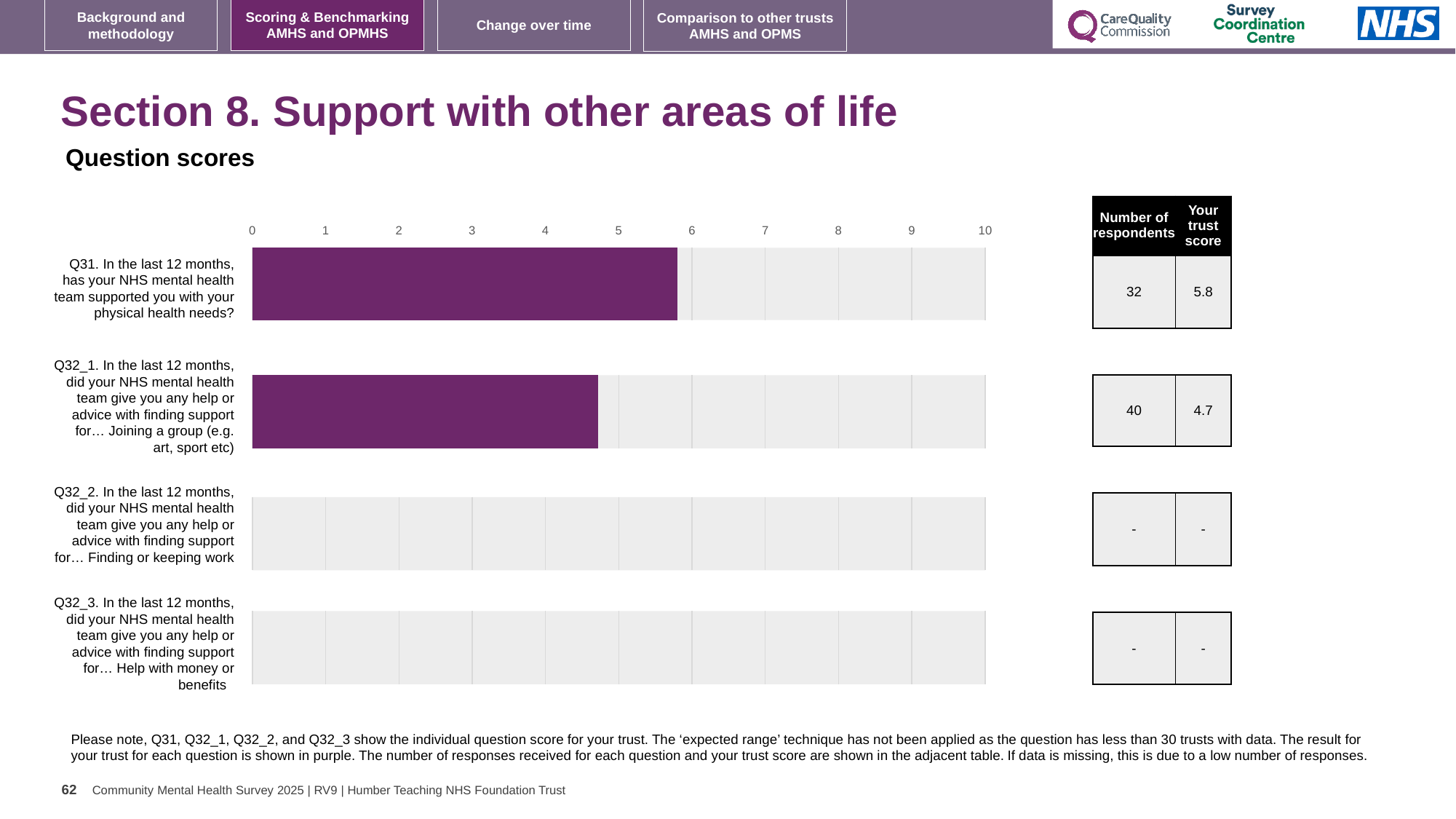
Is the trust score for Q32_1 greater or less than 5? less What is the maximum value shown on the chart's axis? 10 Which question has the highest trust score on the chart? Q31 How many respondents answered Q31? 32 How many questions are listed on the chart? 4 What is the trust score for Q32_1 (help or advice with finding support for joining a group)? 4.7 How many respondents answered Q32_1? 40 What is the difference between the trust scores for Q31 and Q32_1? 1.1 Which has the larger trust score, Q31 or Q32_1? Q31 Is the trust score for Q31 greater or less than 5? greater What kind of chart is shown on the slide? Bar chart What is the trust score for Q31 (supported you with your physical health needs)? 5.8